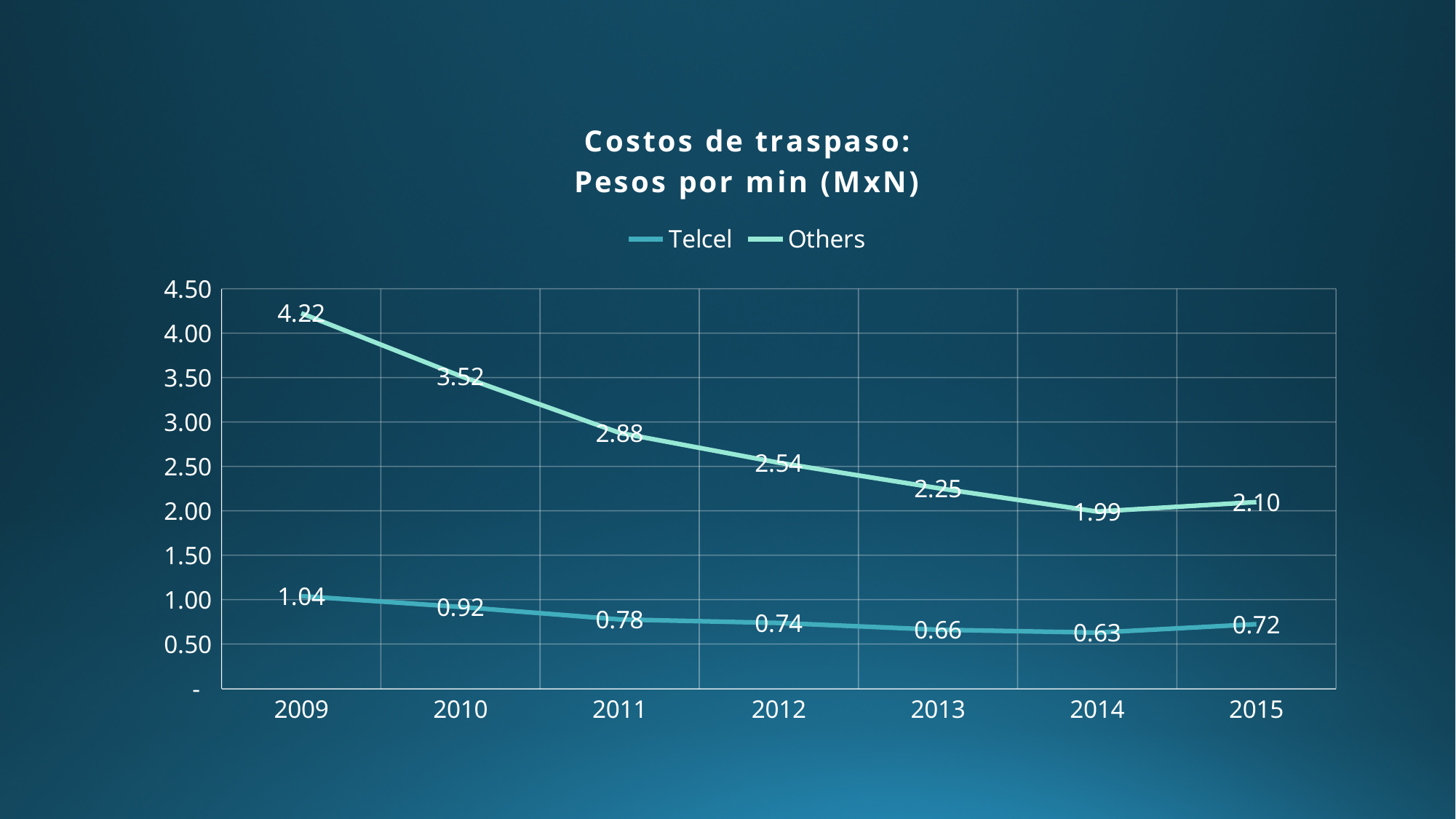
What kind of chart is shown on the slide? Line chart What is the value for Telcel in 2014? 0.63 Does the Others series rise or fall from 2009 to 2014? Fall What is the title of the chart? Costos de traspaso: Pesos por min (MxN) Which series has the larger value in 2013, Telcel or Others? Others What is the value for Others in 2009? 4.22 In which year is the Others value highest? 2009 How many series does the legend list? 2 How many years are shown on the x axis? 7 In which year is the Telcel value lowest? 2014 What is the value for Others in 2015? 2.10 What is the difference between the Others value and the Telcel value in 2011? 2.10